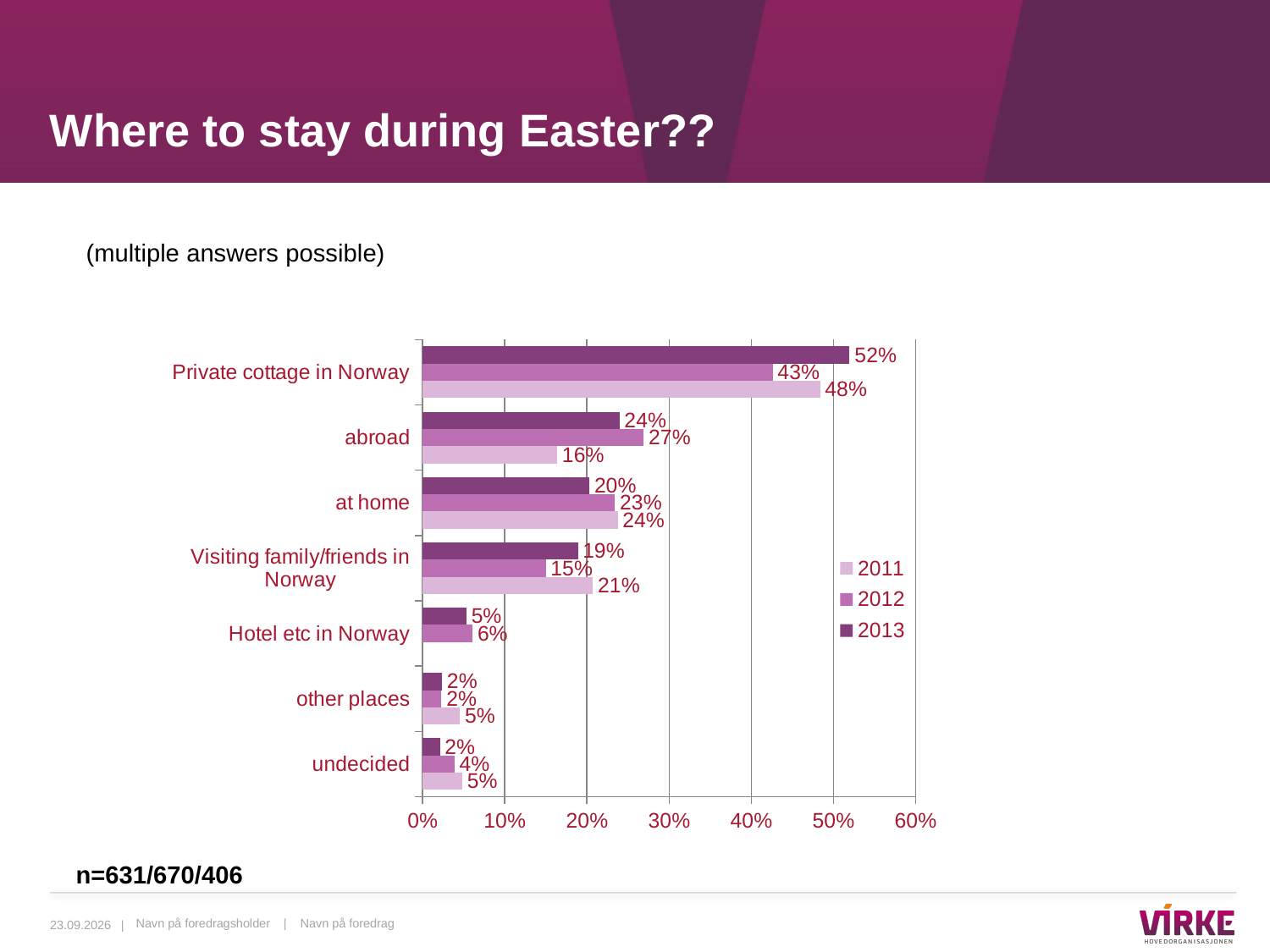
What is the 2011 value for Visiting family/friends in Norway? 21% Which category has the lowest 2012 value? other places Which year is shown in the darkest colour in the legend? 2013 Which category has the highest 2013 value? Private cottage in Norway What is the 2012 value for abroad? 27% What is the difference between the 2013 and 2012 values for Private cottage in Norway? 9% What is the 2013 value for Private cottage in Norway? 52% Is the 2011 value for Private cottage in Norway greater or less than 40%? greater How many categories are shown on the chart? 7 How many series does the legend list? 3 What type of chart is shown on the slide? bar chart Which is larger for at home: the 2011 value or the 2013 value? 2011